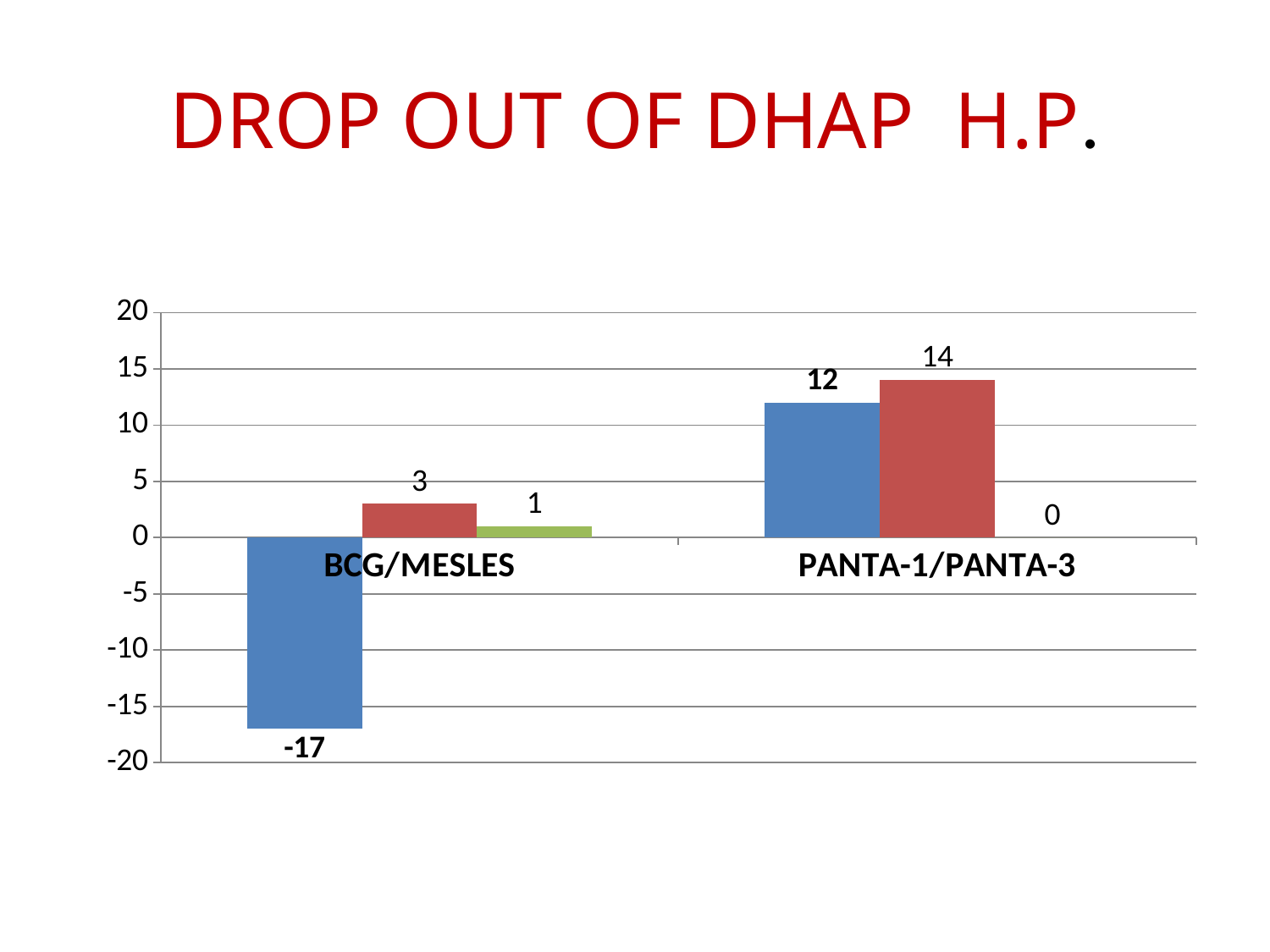
How many categories are shown on the x axis? 2 What is the value of the blue bar for PANTA-1/PANTA-3? 12 What is the value of the red bar for PANTA-1/PANTA-3? 14 Which is larger for PANTA-1/PANTA-3, the blue bar or the red bar? the red bar Which category has the highest red bar value? PANTA-1/PANTA-3 What is the value of the blue bar for BCG/MESLES? -17 What kind of chart is shown on the slide? bar chart Which category has the lowest blue bar value? BCG/MESLES What is the title of the slide? DROP OUT OF DHAP H.P. What is the value of the green bar for BCG/MESLES? 1 What is the difference between the red bar values for PANTA-1/PANTA-3 and BCG/MESLES? 11 What is the value of the green bar for PANTA-1/PANTA-3? 0